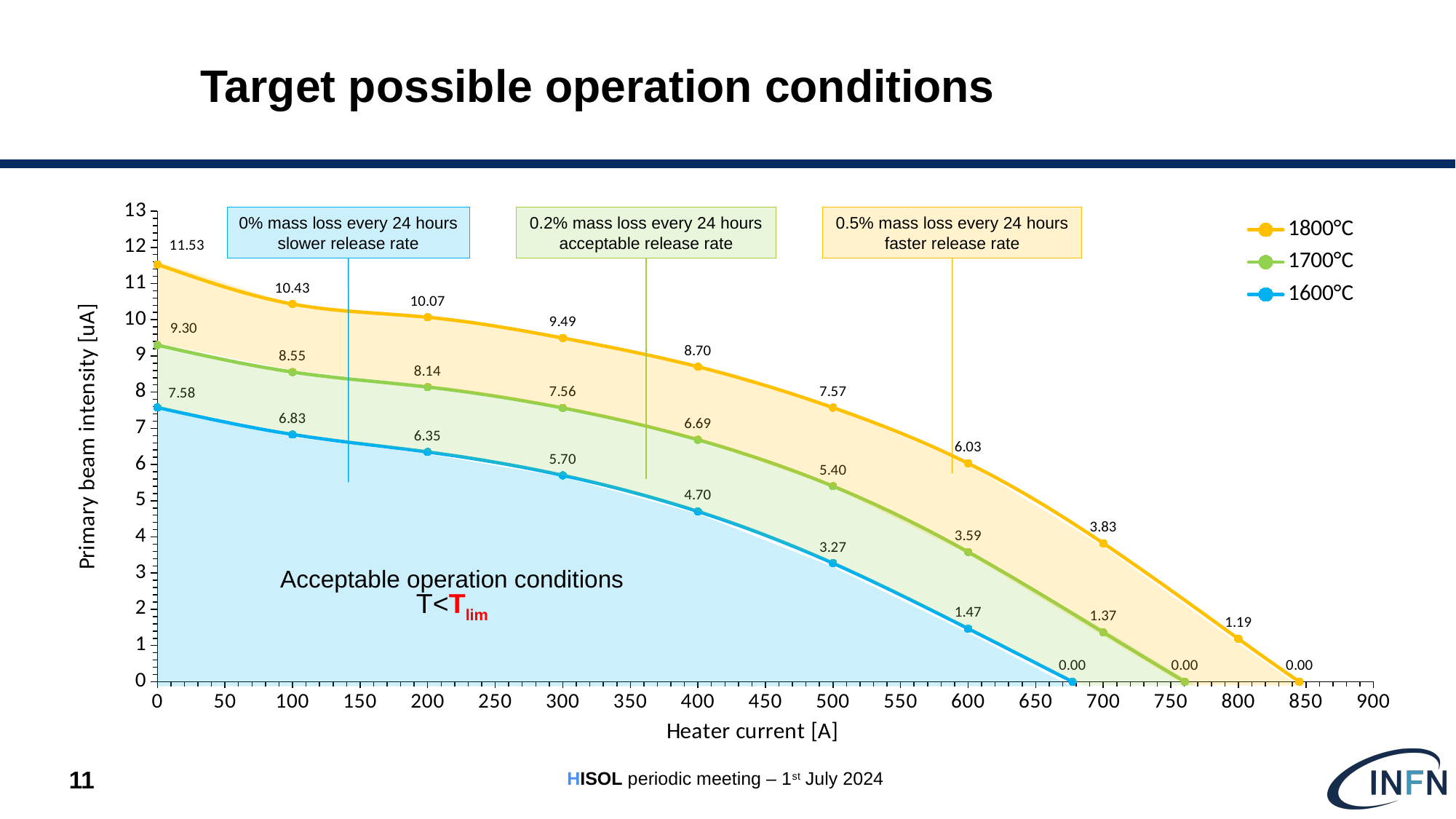
What is the primary beam intensity for the 1800°C series at a heater current of 0 A? 11.53 What kind of chart is shown on the slide? Line chart What is the primary beam intensity for the 1800°C series at a heater current of 700 A? 3.83 How many series does the legend list? 3 What is the primary beam intensity for the 1600°C series at a heater current of 300 A? 5.70 What is the difference between the 1800°C and 1600°C primary beam intensities at a heater current of 500 A? 4.30 What is the primary beam intensity for the 1700°C series at a heater current of 400 A? 6.69 Which series has the lowest primary beam intensity at a heater current of 100 A? 1600°C Which series has the highest primary beam intensity at a heater current of 200 A? 1800°C Does the primary beam intensity for the 1700°C series rise or fall as heater current increases? Fall Which series has the higher primary beam intensity at a heater current of 600 A, 1700°C or 1600°C? 1700°C What is the label of the x axis? Heater current [A]